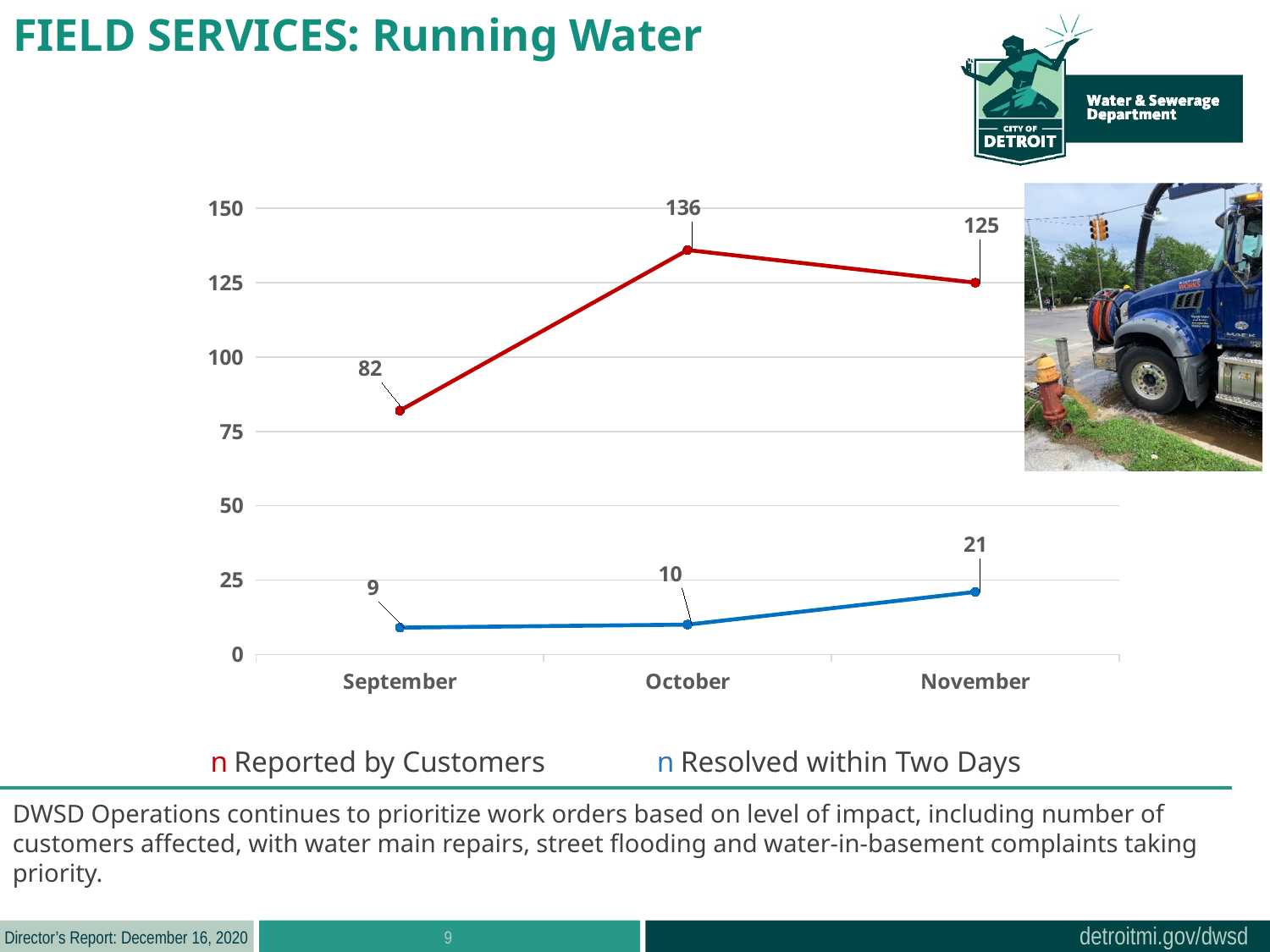
What is the value for Resolved within Two Days in November? 21 In which month is the Reported by Customers value highest? October What colour is the line for Reported by Customers? Red Which is larger: Reported by Customers in September or Reported by Customers in November? November How many months are shown on the x axis? 3 What is the value for Reported by Customers in October? 136 How many series does the legend list? 2 What is the difference between Reported by Customers and Resolved within Two Days in November? 104 What is the value for Reported by Customers in September? 82 In which month is the Resolved within Two Days value lowest? September Does the Resolved within Two Days series rise or fall from September to November? Rise What kind of chart is shown on the slide? Line chart